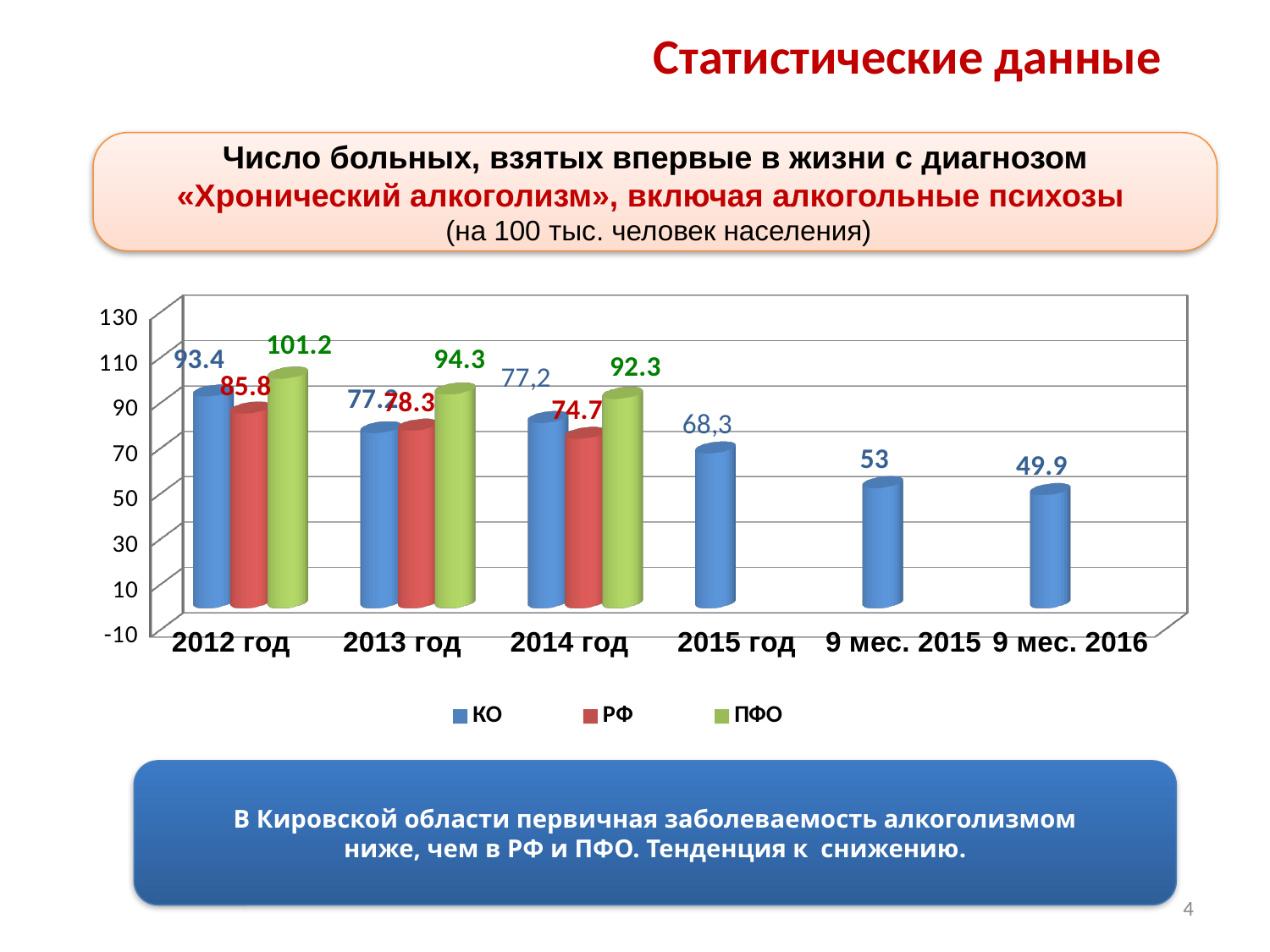
How many series does the legend list? 3 What is the value for РФ in 2014 год? 74.7 What is the value for КО in 9 мес. 2015? 53 What is the difference between the ПФО and КО values in 2012 год? 7.8 Which is larger in 2014 год, the РФ value or the ПФО value? ПФО Is the value for КО in 2015 год greater or less than 70? less In which category does ПФО have its highest value? 2012 год What is the value for КО in 9 мес. 2016? 49.9 What is the value for ПФО in 2012 год? 101.2 Does the КО value rise or fall from 2012 год to 9 мес. 2016? fall In which category does КО have its lowest value? 9 мес. 2016 How many categories are shown on the x axis? 6